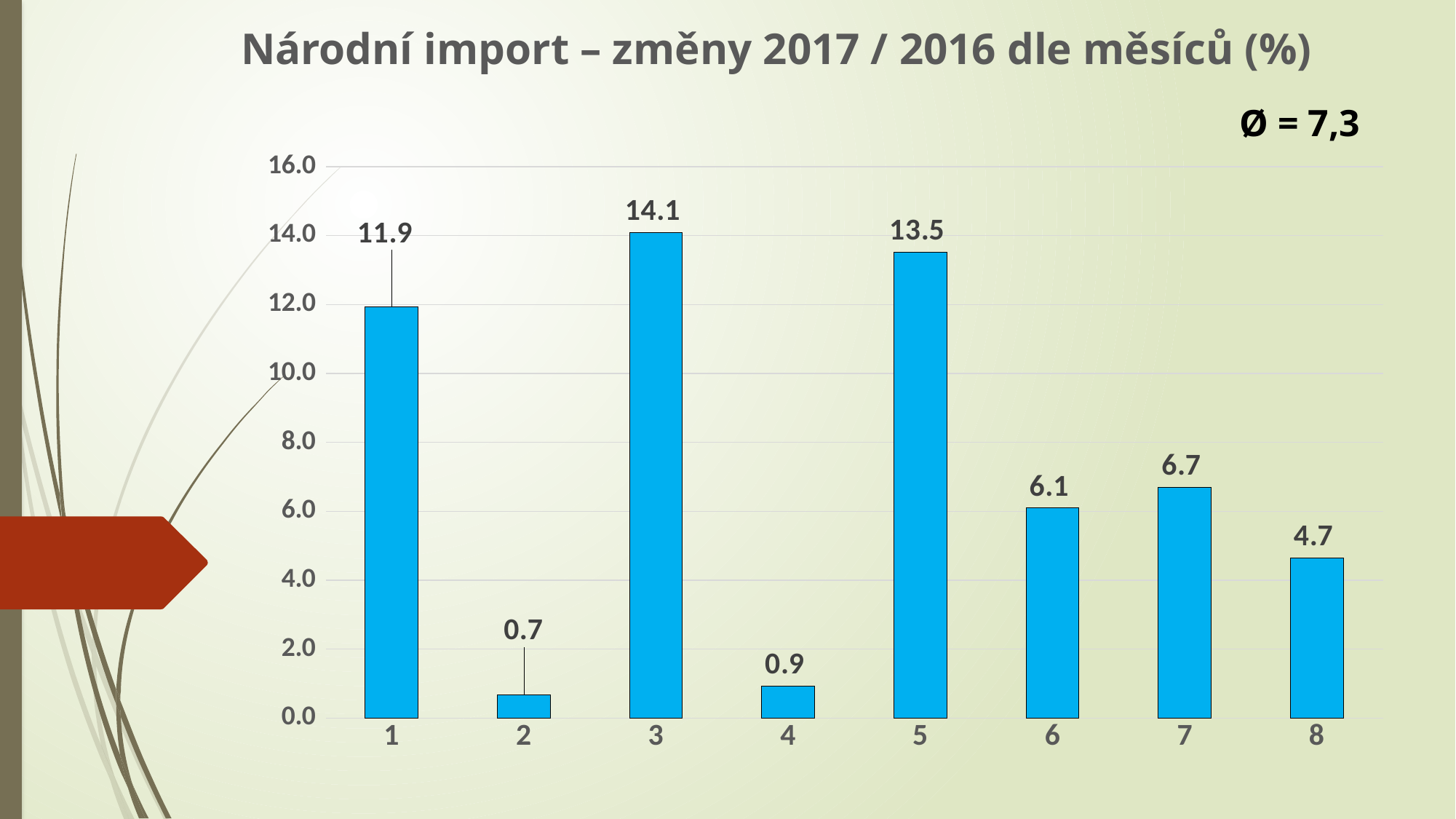
How many months are shown on the x axis? 8 Which month has the highest value? 3 What is the value for month 2? 0.7 What is the difference between the values for month 3 and month 5? 0.6 What is the title of the chart? Národní import – změny 2017 / 2016 dle měsíců (%) Is the value for month 1 greater or less than 10.0? greater What kind of chart is shown on the slide? bar chart What is the value for month 3? 14.1 Which month has the lowest value? 2 What is the value for month 8? 4.7 Which is larger, the value for month 6 or the value for month 7? month 7 What average value (Ø) is printed on the slide? 7,3